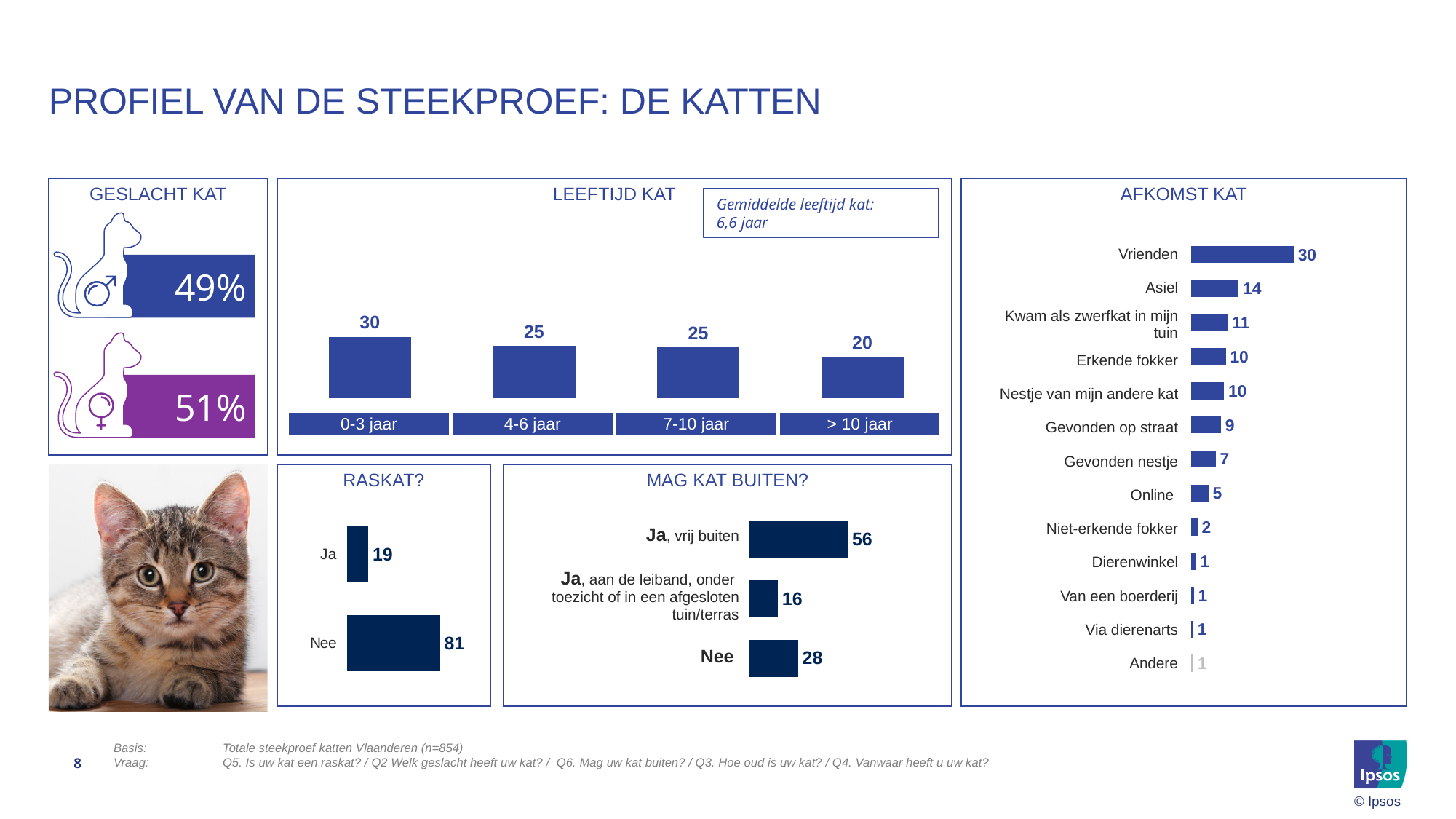
In the LEEFTIJD KAT chart, what is the value for 0-3 jaar? 30 In the LEEFTIJD KAT chart, how many age categories are shown? 4 What kind of chart is the AFKOMST KAT chart? bar chart In the LEEFTIJD KAT chart, do the values rise or fall from 0-3 jaar to > 10 jaar? fall In the LEEFTIJD KAT chart, which age category has the lowest value? > 10 jaar In the AFKOMST KAT chart, what is the value for Asiel? 14 In the AFKOMST KAT chart, what is the difference between Vrienden and Gevonden op straat? 21 In the MAG KAT BUITEN? chart, what is the value for Ja, vrij buiten? 56 In the RASKAT? chart, what is the value for Nee? 81 In the AFKOMST KAT chart, how many categories are listed? 13 In the AFKOMST KAT chart, which category has the highest value? Vrienden In the MAG KAT BUITEN? chart, which is larger: Nee or Ja, aan de leiband, onder toezicht of in een afgesloten tuin/terras? Nee